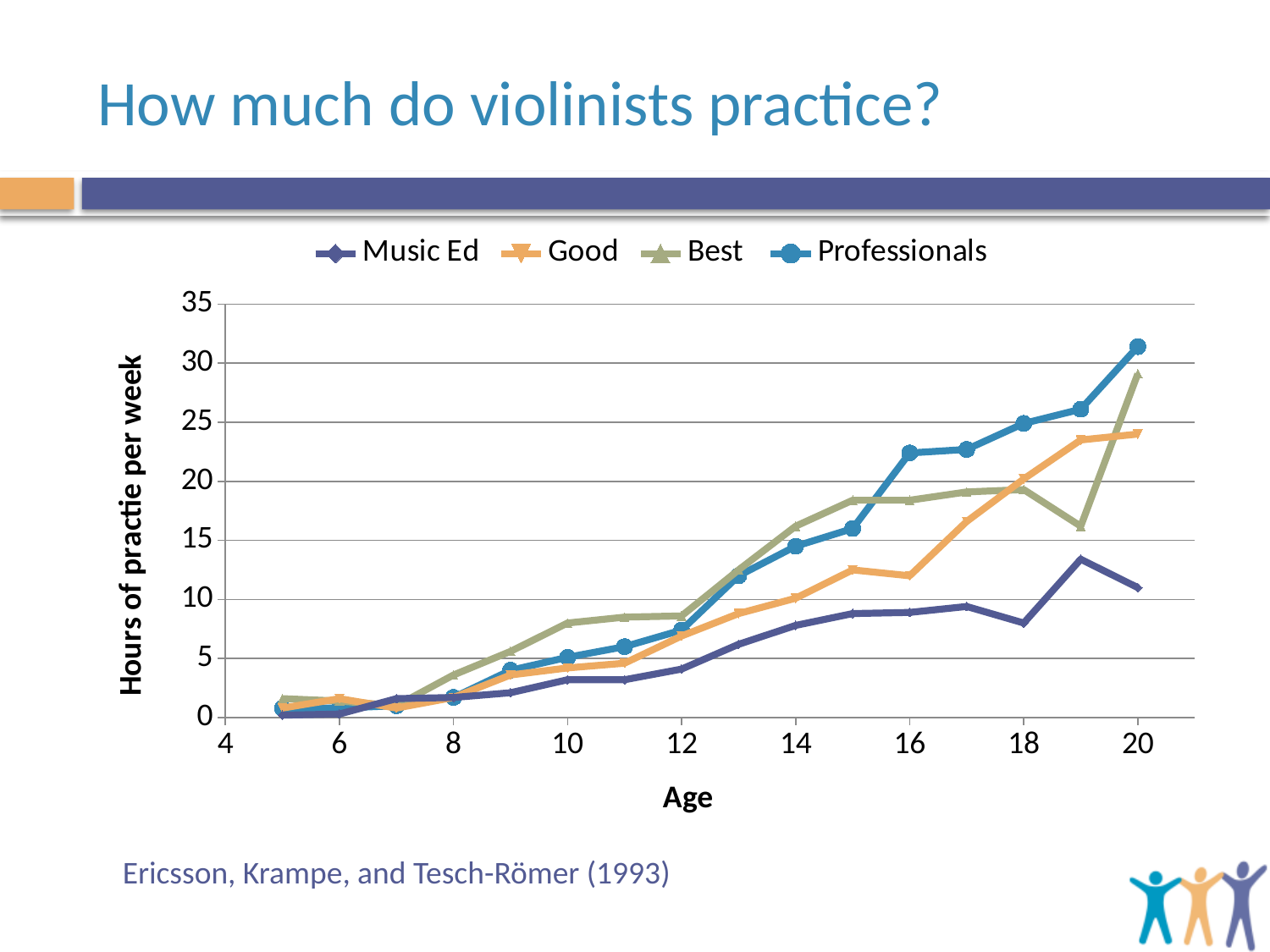
Do the values for Professionals generally rise or fall as age increases? rise What is the title of the x axis? Age What are the series names listed in the legend? Music Ed, Good, Best, Professionals Is the value for Best at age 20 greater or less than 25? greater How many series does the legend list? 4 What kind of chart is shown on the slide? line chart At age 12, which is larger: the value for Best or the value for Music Ed? Best Is the value for Professionals at age 20 greater or less than 30? greater Which series has the lowest value at age 20? Music Ed Is the value for Music Ed at age 20 greater or less than 15? less Which series has the highest value at age 20? Professionals